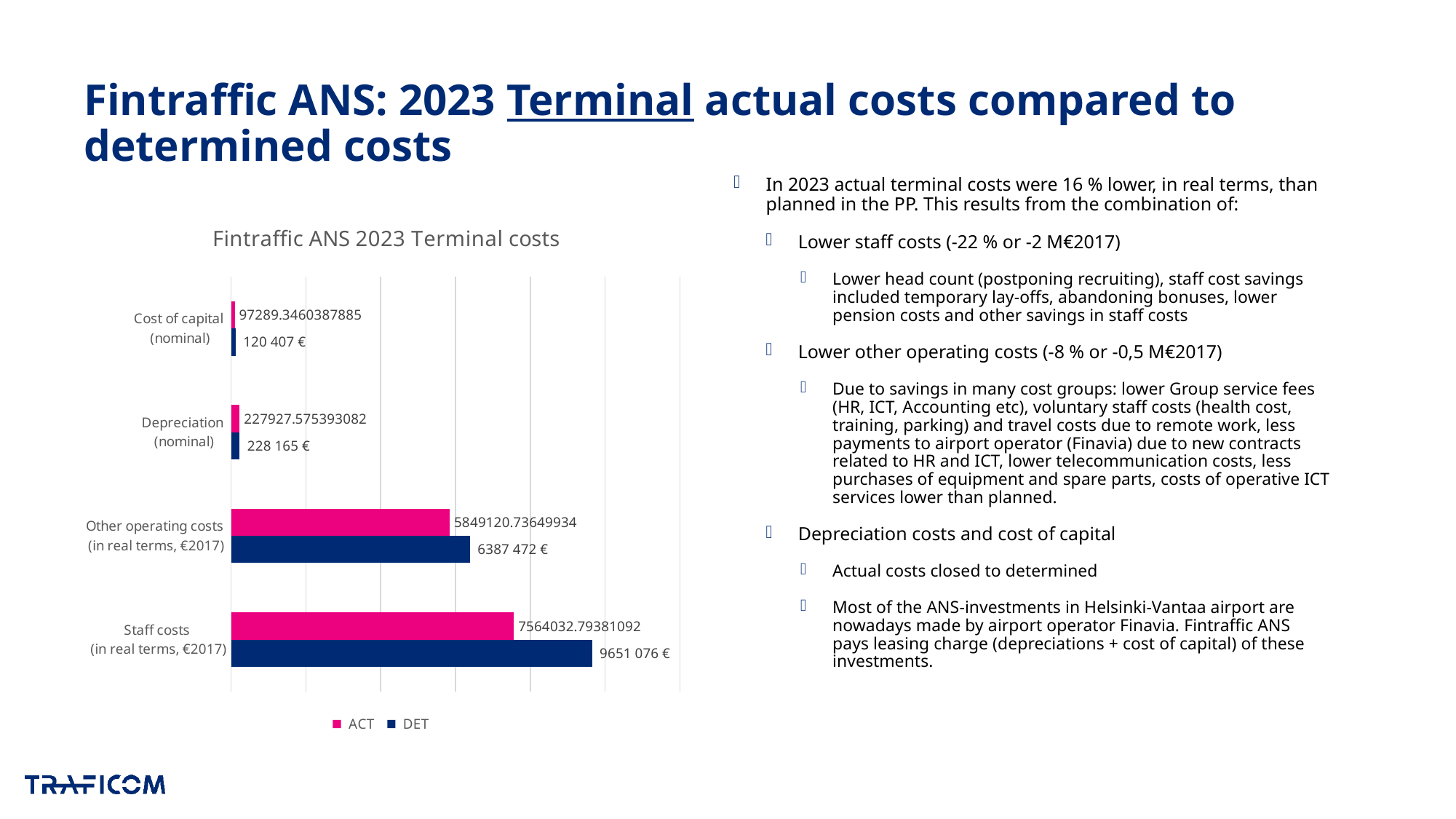
What type of chart is shown on the slide? bar chart What is the DET value for Other operating costs (in real terms, €2017)? 6387 472 € What is the DET value for Depreciation (nominal)? 228 165 € What is the DET value for Staff costs (in real terms, €2017)? 9651 076 € How many series does the chart legend list? 2 What is the ACT value for Cost of capital (nominal)? 97289.3460387885 Which category has the lowest ACT value? Cost of capital (nominal) How many cost categories are shown in the chart? 4 What is the title of the chart? Fintraffic ANS 2023 Terminal costs Which category has the highest DET value? Staff costs (in real terms, €2017) For Staff costs, which is larger: the ACT value or the DET value? DET What is the ACT value for Staff costs (in real terms, €2017)? 7564032.79381092